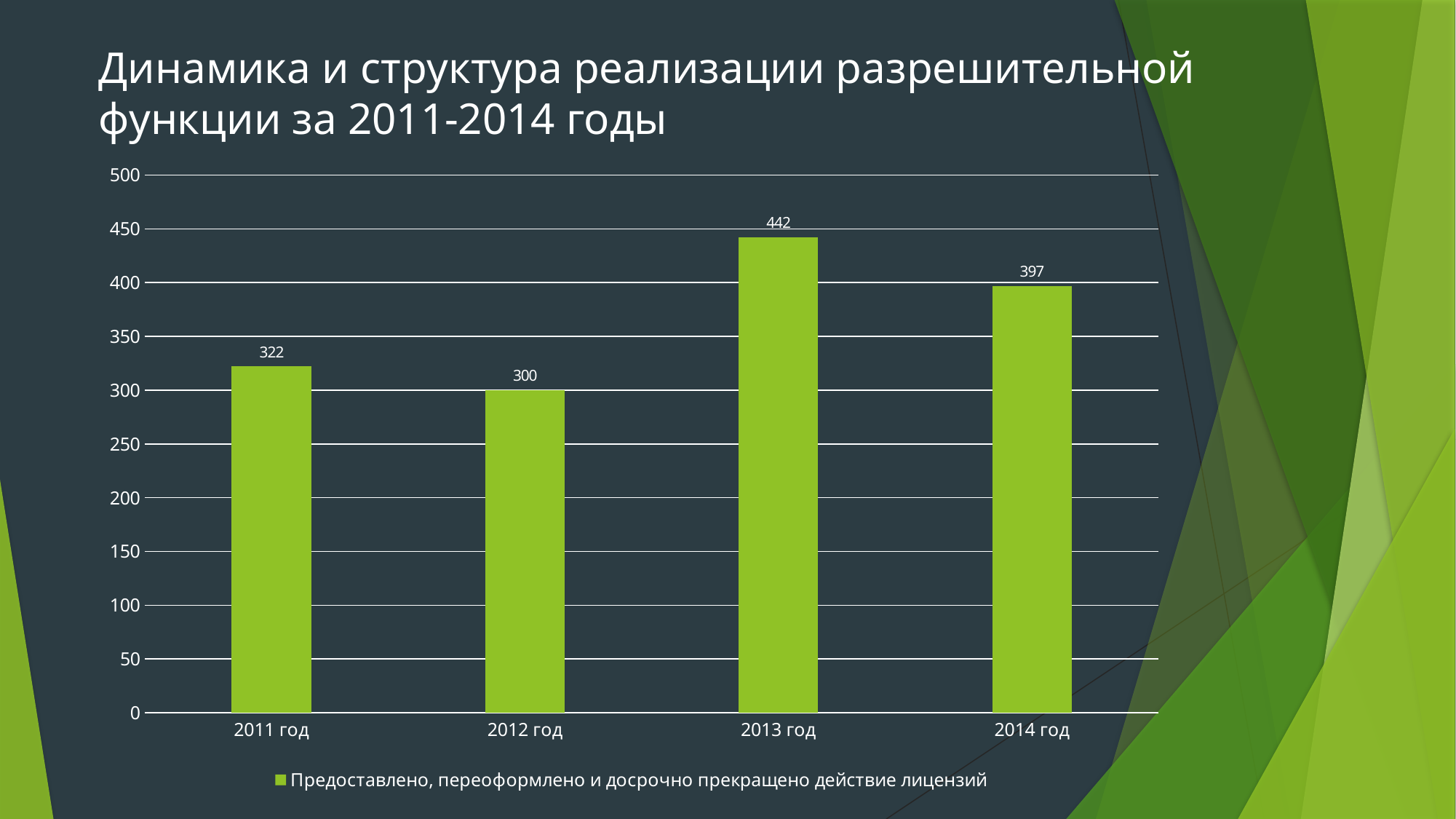
Which year has the lowest value? 2012 год What is the legend entry for the series shown? Предоставлено, переоформлено и досрочно прекращено действие лицензий What kind of chart is shown on the slide? bar chart What is the difference between the values for 2014 год and 2011 год? 75 What is the value for 2014 год? 397 How many years are shown on the x axis? 4 What is the value for 2011 год? 322 Which year has the highest value? 2013 год What is the difference between the values for 2013 год and 2012 год? 142 What is the value for 2013 год? 442 Is the value for 2013 год greater or less than 400? greater Which is larger, the value for 2011 год or the value for 2014 год? 2014 год